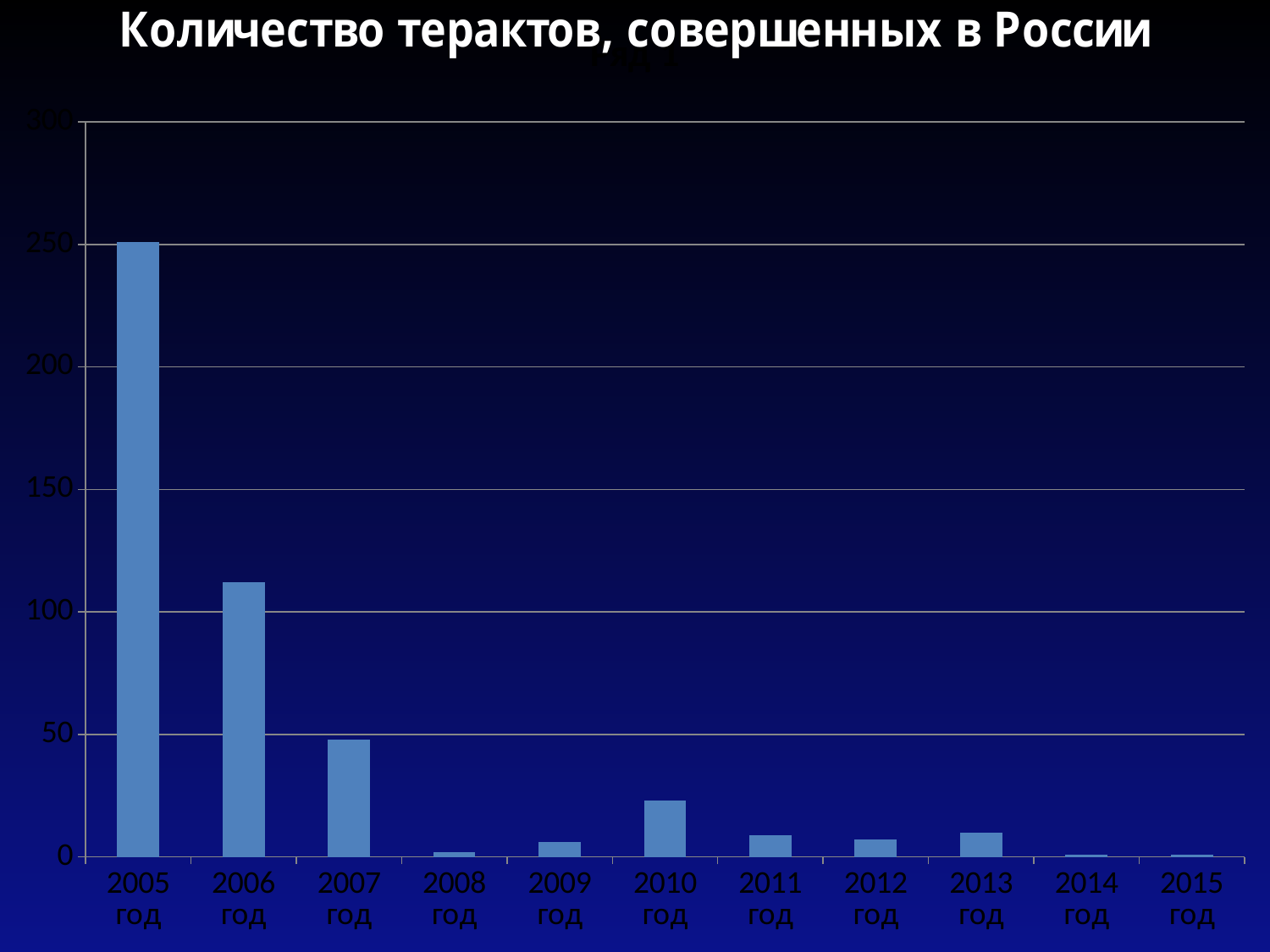
Is the value for 2005 год greater or less than 200? greater Overall, do the values rise or fall from 2005 год to 2015 год? fall Is the value for 2010 год greater or less than 50? less How many years (categories) are shown on the x axis? 11 Is the value for 2006 год greater or less than 150? less Which is larger, the value for 2007 год or the value for 2010 год? 2007 год Which is larger, the value for 2005 год or the value for 2006 год? 2005 год Which year has the highest bar? 2005 год What is the title of the chart? Количество терактов, совершенных в России What kind of chart is shown on the slide? Bar chart